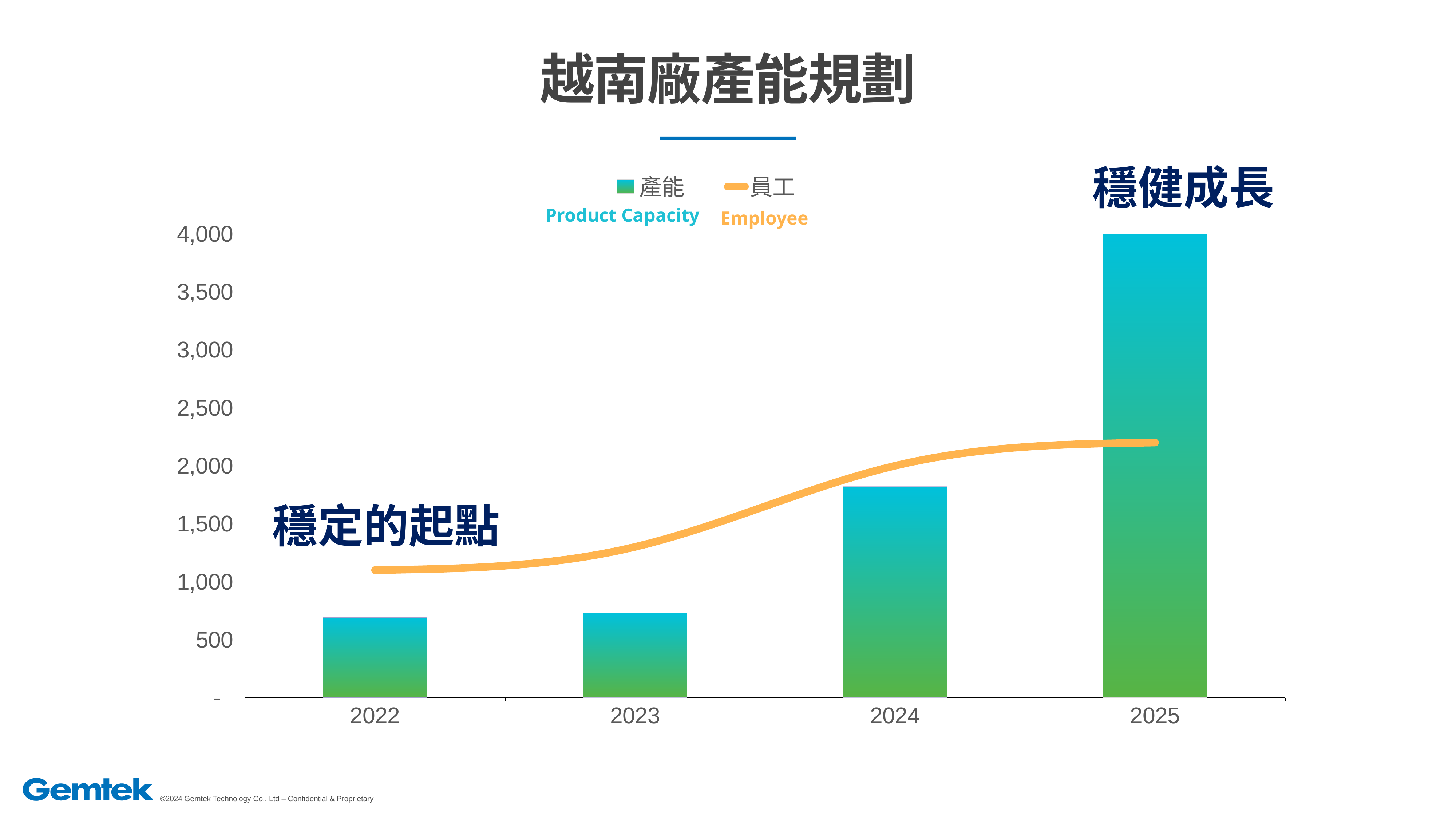
What is the title of the chart on the slide? 越南廠產能規劃 Do the Employee (員工) values rise or fall from 2022 to 2025? rise Is the Employee (員工) value for 2022 greater or less than 1,500? less Is the Employee (員工) value for 2025 greater or less than 2,000? greater What kind of chart is shown on the slide? A bar chart combined with a line chart Which year has the highest Product Capacity (產能) bar? 2025 Is the Product Capacity (產能) value for 2024 greater or less than 1,500? greater Which is larger, the Product Capacity (產能) bar for 2024 or for 2025? 2025 How many series does the chart legend list? 2 How many years are shown on the x axis of the chart? 4 Which series is drawn as a line in the chart? 員工 (Employee)